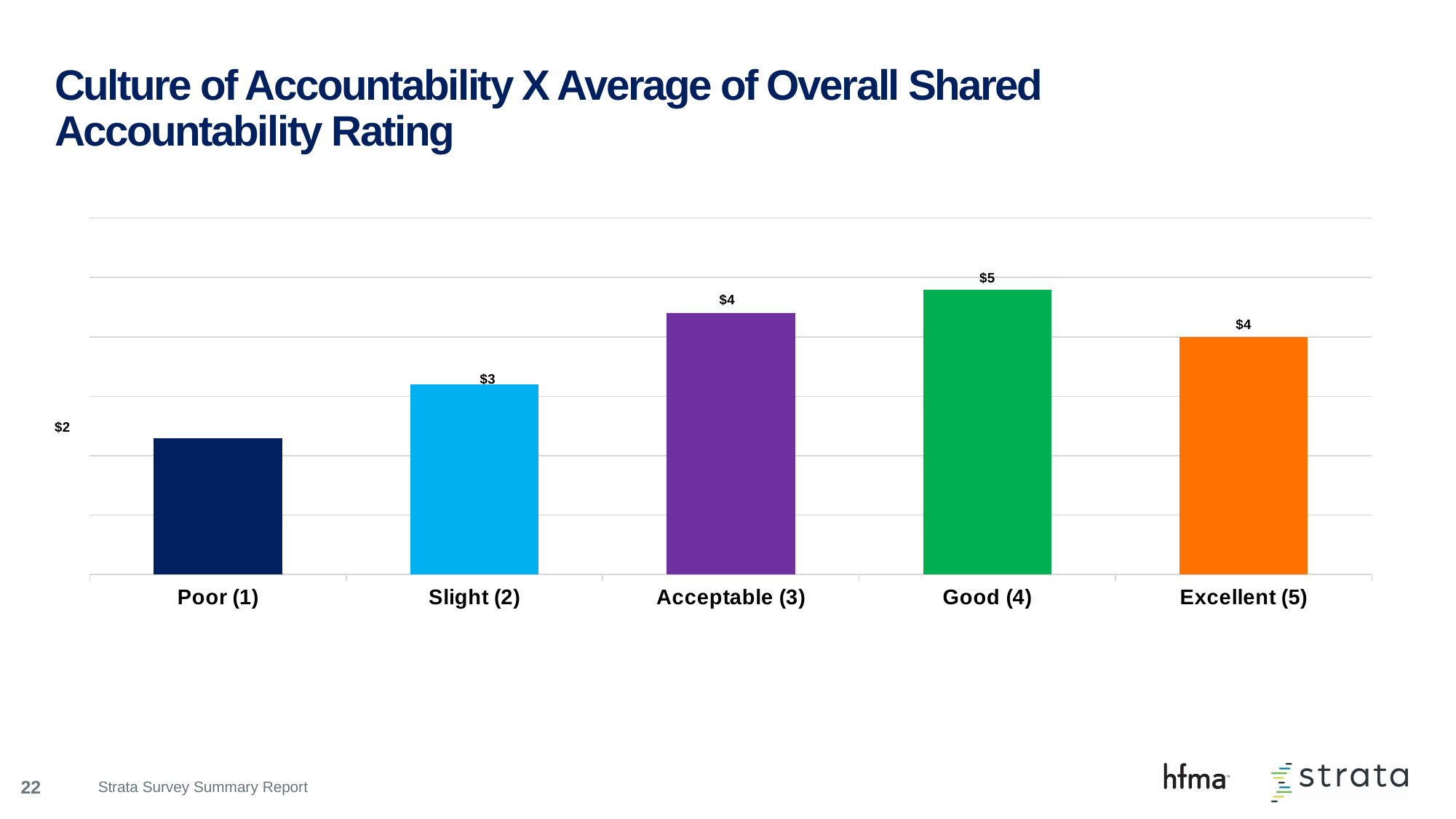
What is the value shown for Poor (1)? $2 What is the difference between the values for Good (4) and Poor (1)? $3 Do the values rise or fall from Poor (1) to Good (4)? Rise What is the value shown for Slight (2)? $3 What is the value shown for Excellent (5)? $4 What is the difference between the values for Slight (2) and Poor (1)? $1 Which is larger, the value for Good (4) or the value for Slight (2)? Good (4) Which category has the lowest value? Poor (1) What is the value shown for Good (4)? $5 How many categories are shown on the x axis? 5 Which category has the highest value? Good (4) What kind of chart is shown on the slide? Bar chart